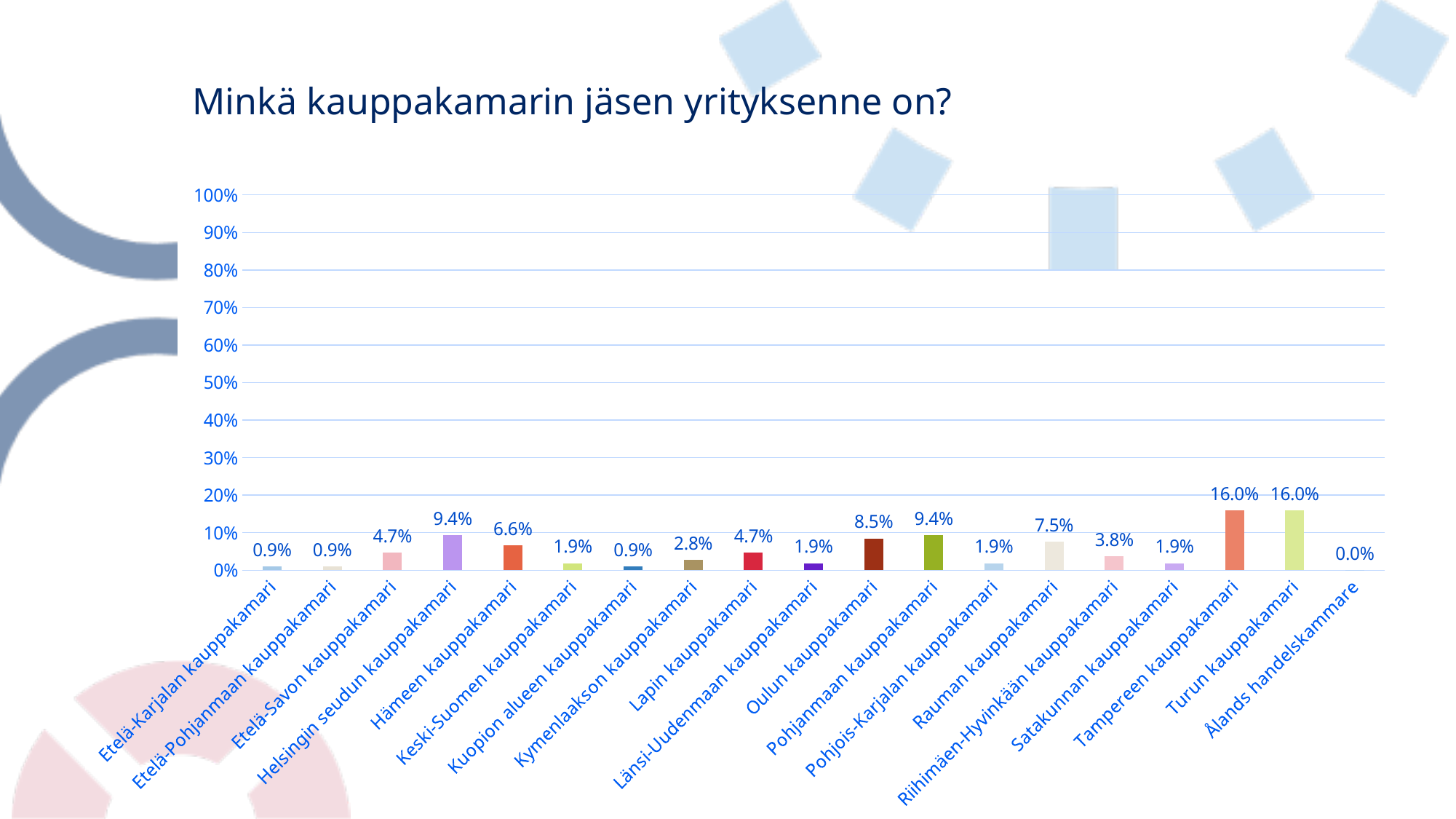
Which two categories share the highest value? Tampereen kauppakamari and Turun kauppakamari Which is larger, the value for Helsingin seudun kauppakamari or the value for Hämeen kauppakamari? Helsingin seudun kauppakamari What is the value for Riihimäen-Hyvinkään kauppakamari? 3.8% What is the difference between the values for Turun kauppakamari and Rauman kauppakamari? 8.5% What is the value for Oulun kauppakamari? 8.5% How many categories are shown on the x axis? 19 What is the value for Ålands handelskammare? 0.0% Which category has the lowest value? Ålands handelskammare What kind of chart is shown on the slide? Bar chart What is the value for Hämeen kauppakamari? 6.6% Is the value for Pohjanmaan kauppakamari greater or less than 10%? less What is the value for Tampereen kauppakamari? 16.0%